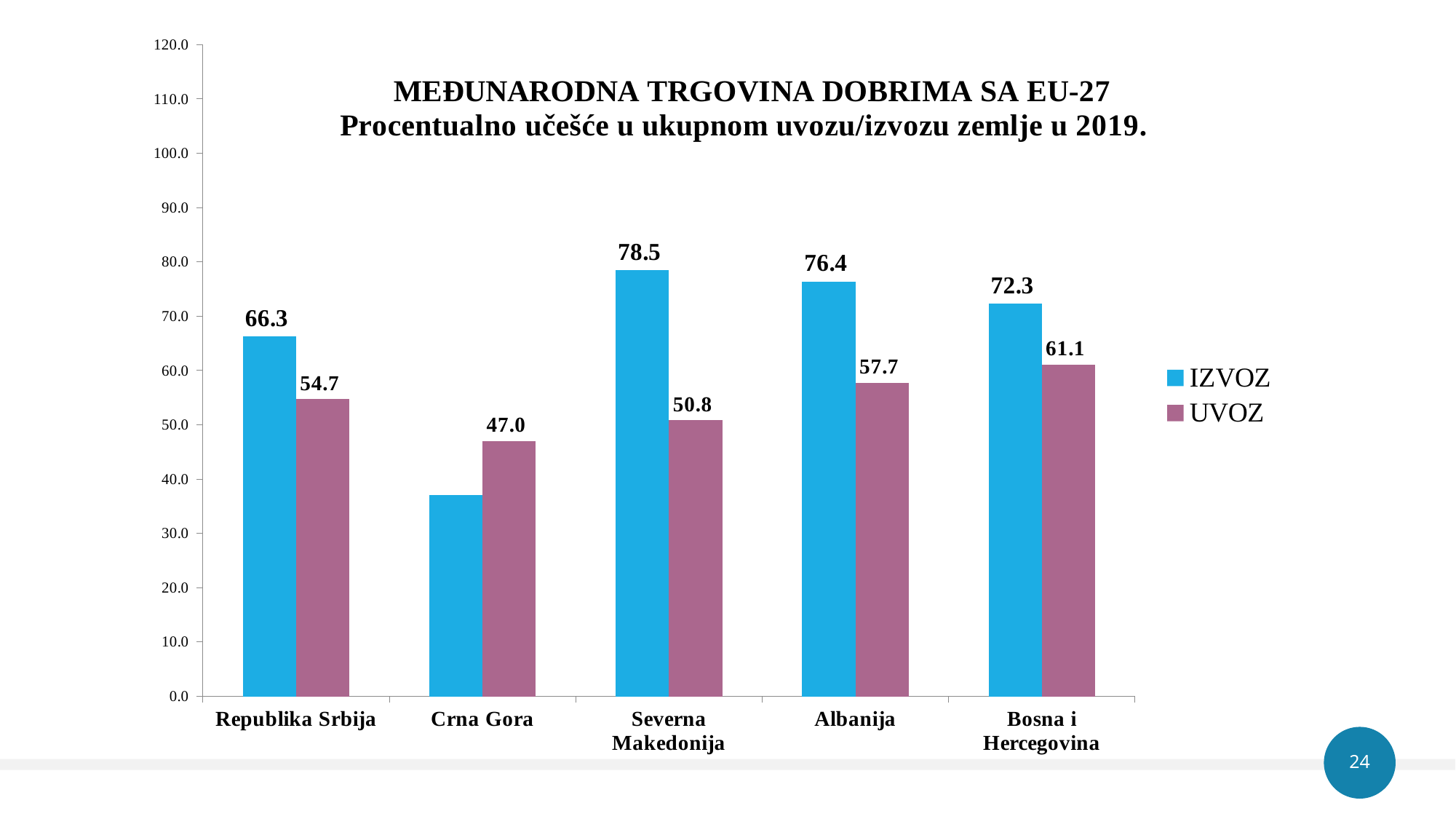
Which country has the highest IZVOZ value? Severna Makedonija What is the difference between the IZVOZ and UVOZ values for Republika Srbija? 11.6 Is the IZVOZ value for Crna Gora greater or less than 40.0? less What is the UVOZ value for Bosna i Hercegovina? 61.1 What is the UVOZ value for Crna Gora? 47.0 What kind of chart is shown on the slide? bar chart Which colour represents the UVOZ series? purple How many series does the legend list? 2 Which country has the lowest UVOZ value? Crna Gora Which is larger for Albanija, IZVOZ or UVOZ? IZVOZ What is the IZVOZ value for Severna Makedonija? 78.5 How many countries are shown on the x axis? 5